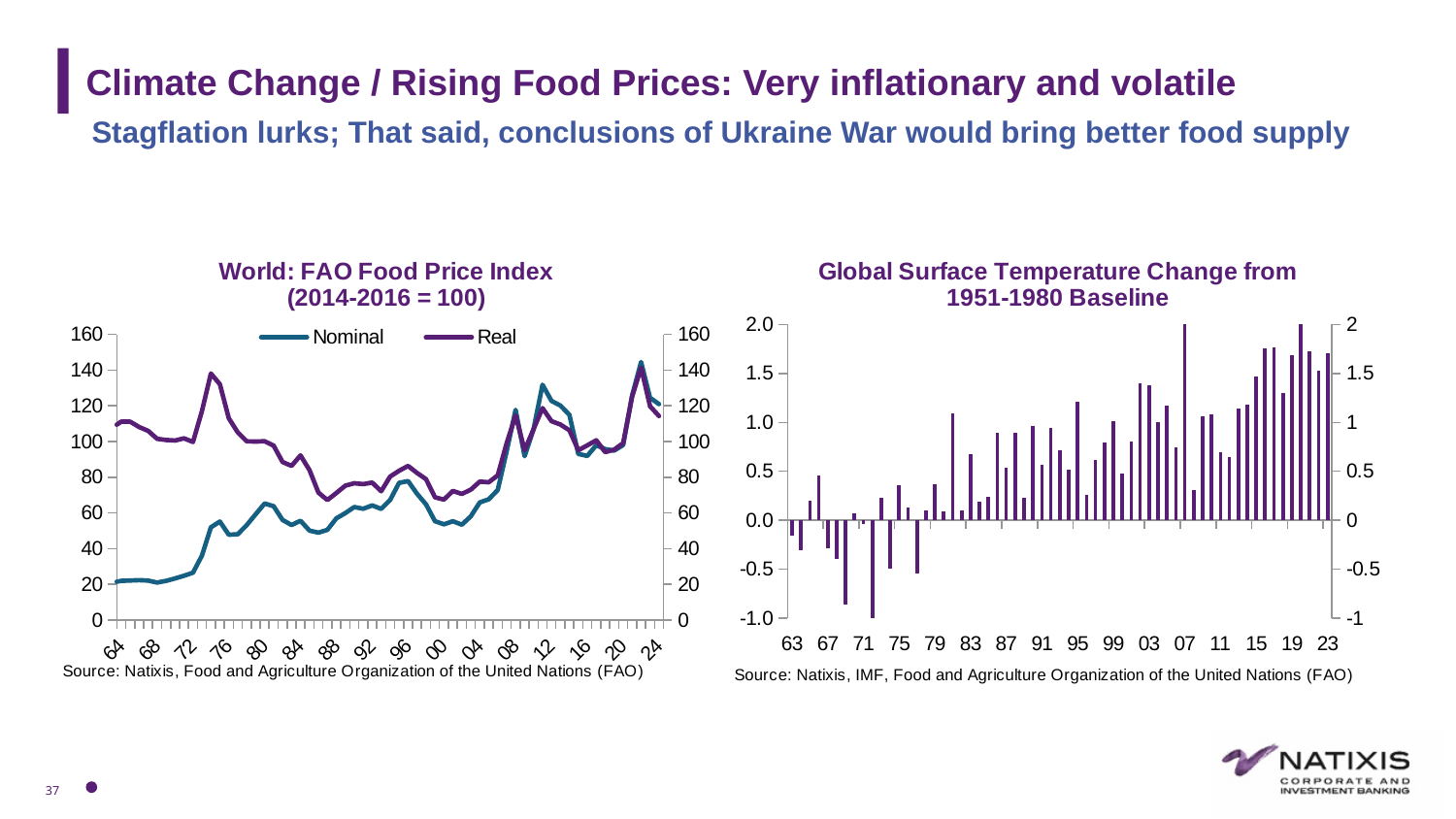
How many series does the legend of the 'World: FAO Food Price Index' chart list? 2 In the 'World: FAO Food Price Index' chart, which series is higher in 1964, Nominal or Real? Real In the 'World: FAO Food Price Index' chart, is the Nominal value in 1964 greater or less than 40? less In the 'Global Surface Temperature Change from 1951-1980 Baseline' chart, is the value for 2023 greater or less than 1.5? greater In the 'World: FAO Food Price Index' chart, is the Real value in 1964 greater or less than 100? greater What kind of chart is the 'World: FAO Food Price Index' chart on the left? line chart In the 'Global Surface Temperature Change from 1951-1980 Baseline' chart, do the values generally rise or fall from 1963 to 2023? rise In the 'World: FAO Food Price Index' chart, which two series are shown in the legend? Nominal and Real In the 'World: FAO Food Price Index' chart, does the Nominal series overall rise or fall from 1964 to 2024? rise In the 'Global Surface Temperature Change from 1951-1980 Baseline' chart, which year has the lowest value? 1972 What kind of chart is the 'Global Surface Temperature Change from 1951-1980 Baseline' chart on the right? bar chart